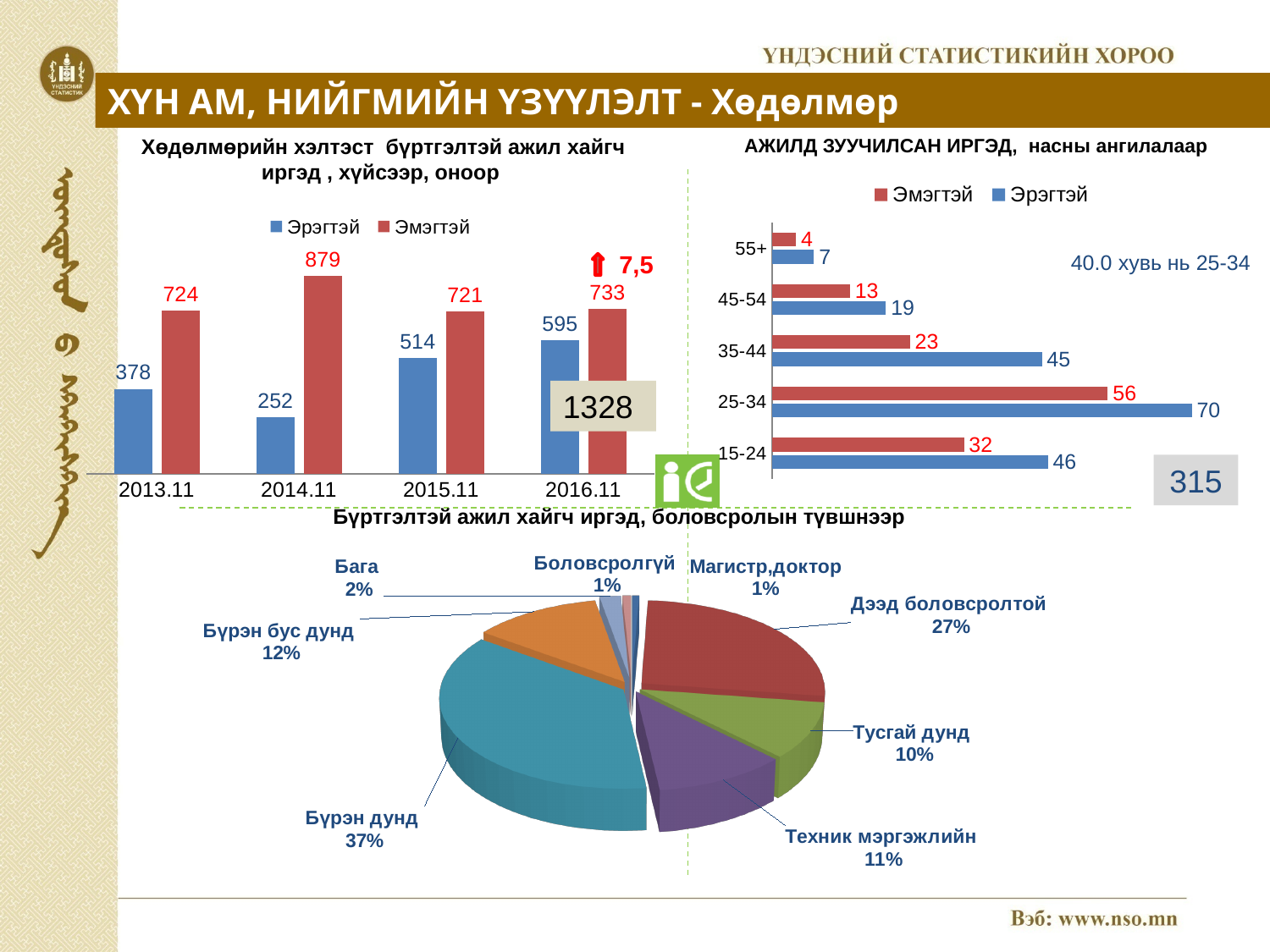
In the top-left chart (Хөдөлмөрийн хэлтэст бүртгэлтэй ажил хайгч иргэд), how many years are shown on the x axis? 4 What kind of chart is the bottom chart (Бүртгэлтэй ажил хайгч иргэд, боловсролын түвшнээр)? Pie chart In the top-right chart (АЖИЛД ЗУУЧИЛСАН ИРГЭД, насны ангилалаар), how many series does the legend list? 2 In the bottom pie chart (Бүртгэлтэй ажил хайгч иргэд, боловсролын түвшнээр), what share does Бүрэн дунд have? 37% In the top-right chart (АЖИЛД ЗУУЧИЛСАН ИРГЭД, насны ангилалаар), which is larger for the 15-24 age group, Эрэгтэй or Эмэгтэй? Эрэгтэй In the top-right chart (АЖИЛД ЗУУЧИЛСАН ИРГЭД, насны ангилалаар), what is the Эрэгтэй value for the 25-34 age group? 70 In the top-left chart (Хөдөлмөрийн хэлтэст бүртгэлтэй ажил хайгч иргэд), in which year is the Эрэгтэй value lowest? 2014.11 In the top-left chart (Хөдөлмөрийн хэлтэст бүртгэлтэй ажил хайгч иргэд), what is the value for Эрэгтэй in 2013.11? 378 In the top-left chart (Хөдөлмөрийн хэлтэст бүртгэлтэй ажил хайгч иргэд), what is the difference between the Эмэгтэй and Эрэгтэй values in 2016.11? 138 In the top-right chart (АЖИЛД ЗУУЧИЛСАН ИРГЭД, насны ангилалаар), what is the Эмэгтэй value for the 45-54 age group? 13 In the top-right chart (АЖИЛД ЗУУЧИЛСАН ИРГЭД, насны ангилалаар), which age group has the highest Эмэгтэй value? 25-34 In the top-left chart (Хөдөлмөрийн хэлтэст бүртгэлтэй ажил хайгч иргэд), what is the value for Эмэгтэй in 2014.11? 879